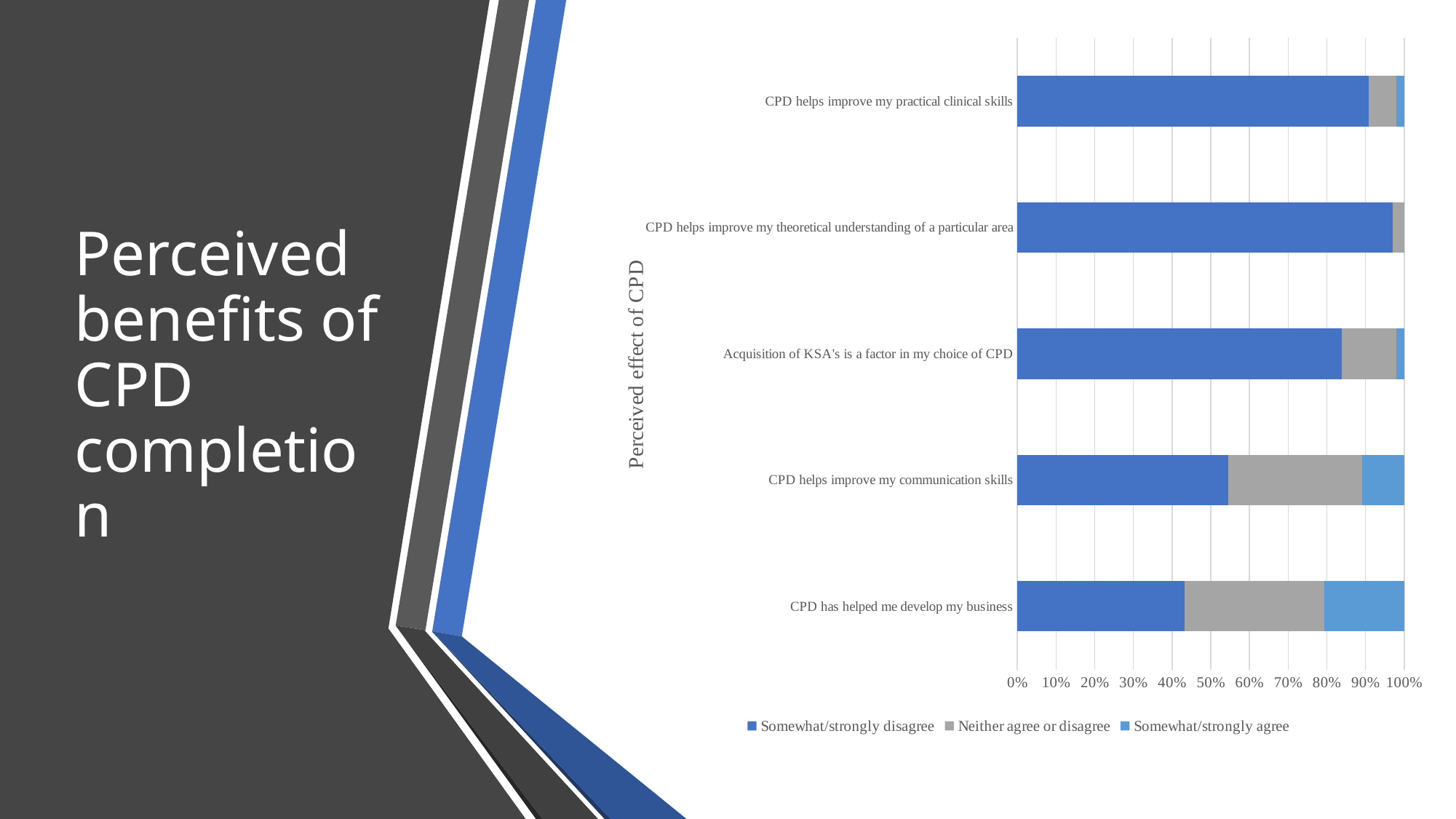
Is the 'Somewhat/strongly disagree' value for 'CPD helps improve my communication skills' greater or less than 50%? greater Which statement has the largest 'Somewhat/strongly agree' share? CPD has helped me develop my business How many series does the chart's legend list? 3 Is the 'Somewhat/strongly disagree' value for 'CPD helps improve my theoretical understanding of a particular area' greater or less than 90%? greater What kind of chart is shown on the slide? Stacked bar chart What is the title of the vertical axis of the chart? Perceived effect of CPD Is the 'Somewhat/strongly disagree' value for 'CPD has helped me develop my business' greater or less than 50%? less How many categories (statements) are plotted on the chart? 5 Which statement has the smallest 'Somewhat/strongly disagree' share? CPD has helped me develop my business Which statement has the largest 'Somewhat/strongly disagree' share? CPD helps improve my theoretical understanding of a particular area Which series is shown in grey in the chart's legend? Neither agree or disagree